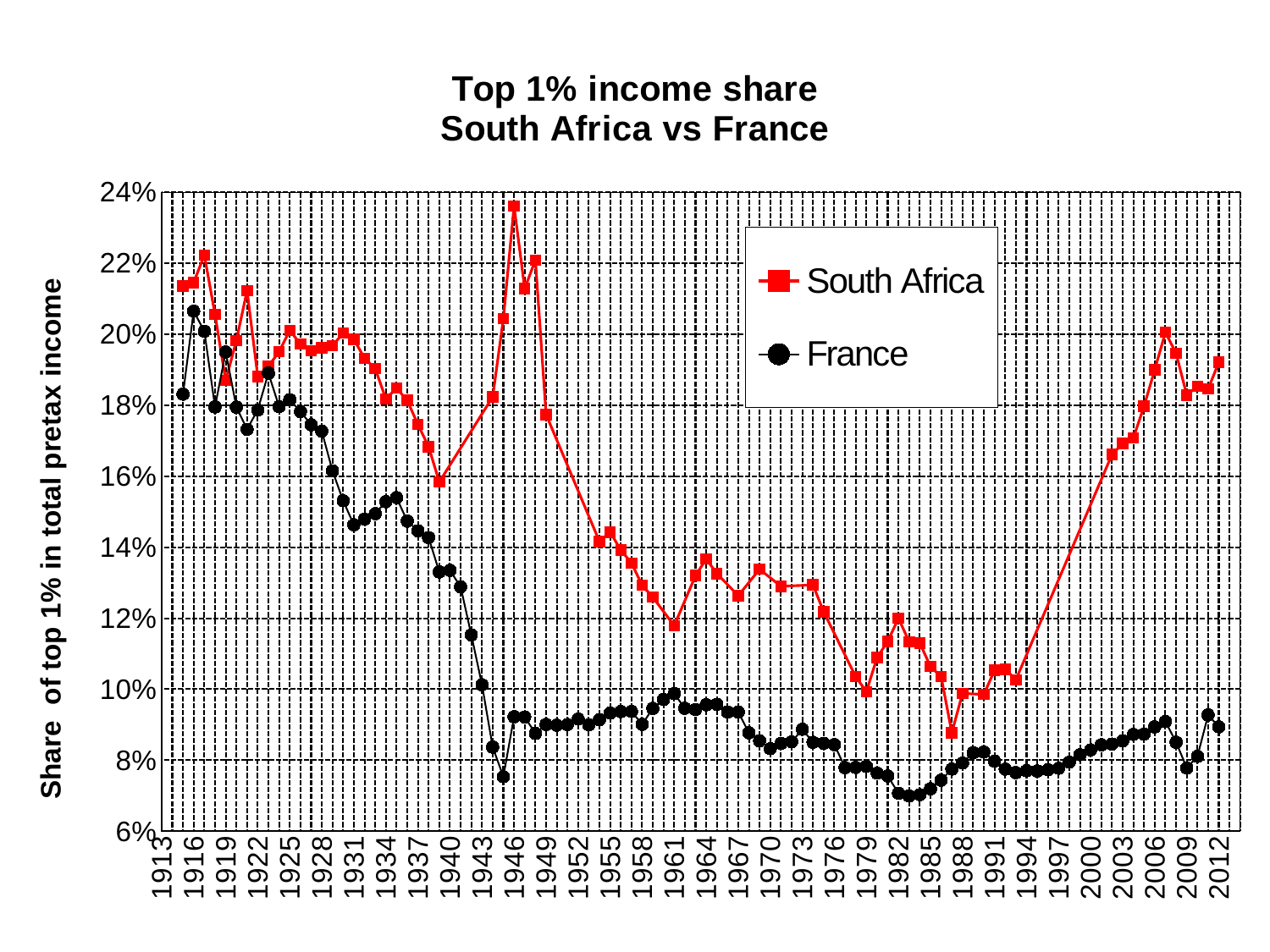
In 1982, which series has the higher value, South Africa or France? South Africa Which series is drawn with red square markers? South Africa What kind of chart is shown on the slide? Line chart Is the value for South Africa in 2006 greater or less than 18%? greater Is the value for France in 1982 greater or less than 8%? less How many series does the legend list? 2 What is the title of the chart? Top 1% income share South Africa vs France Does the France series rise or fall between 1925 and 1943? Fall Does the South Africa series rise or fall between 1994 and 2006? Rise Is the value for South Africa in 1946 greater or less than 22%? greater